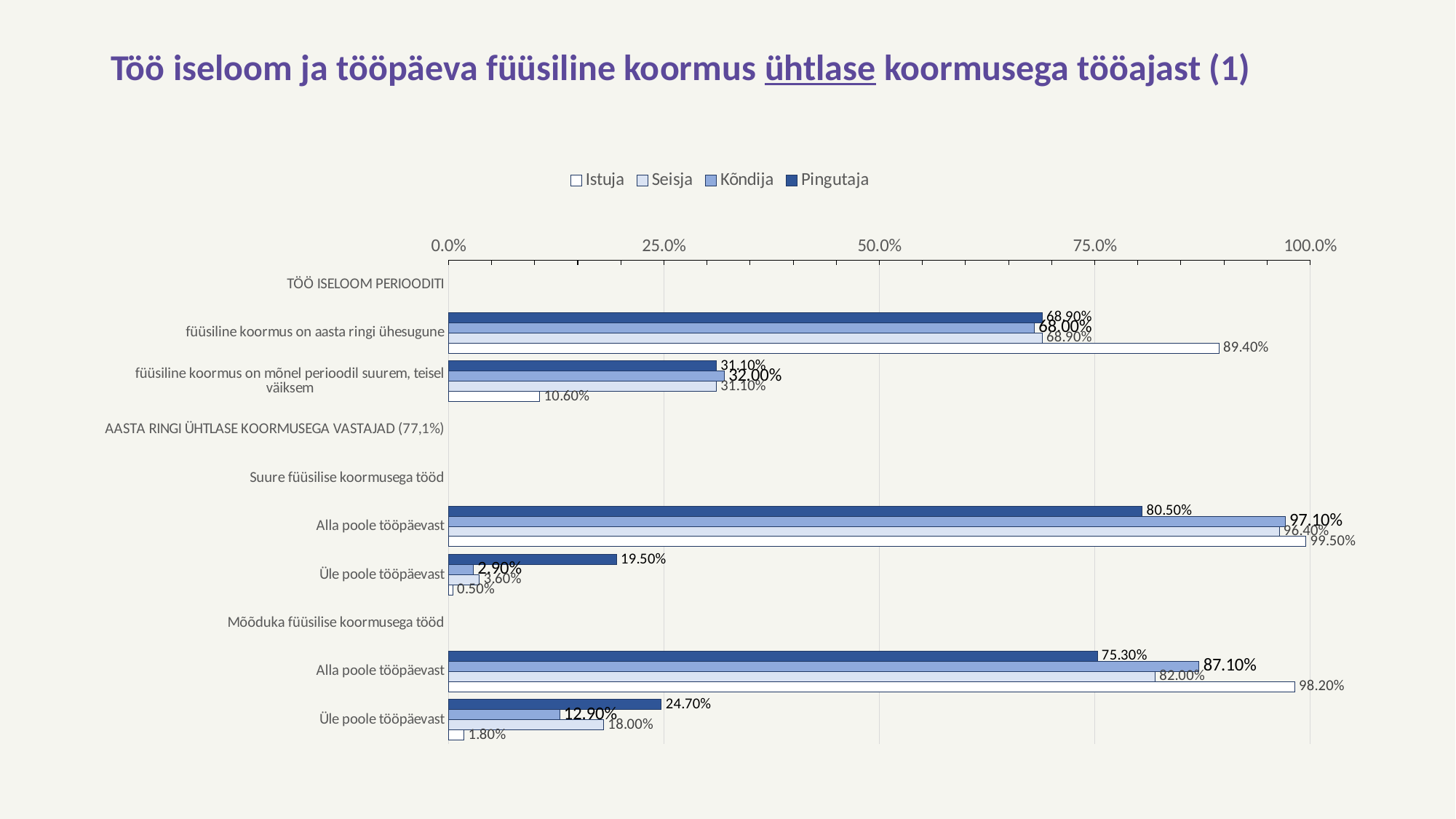
Under 'Suure füüsilise koormusega tööd', what is the value for Istuja in 'Üle poole tööpäevast'? 0.50% Under 'Mõõduka füüsilise koormusega tööd', what is the value for Seisja in 'Alla poole tööpäevast'? 82.00% How many series does the legend list? 4 In the category 'füüsiline koormus on aasta ringi ühesugune', which is larger: Istuja or Pingutaja? Istuja Which series are listed in the legend? Istuja, Seisja, Kõndija, Pingutaja Under 'Suure füüsilise koormusega tööd', which series has the lowest value in 'Üle poole tööpäevast'? Istuja What kind of chart is shown on the slide? bar chart Under 'Mõõduka füüsilise koormusega tööd', what is the value for Kõndija in 'Alla poole tööpäevast'? 87.10% Under 'Mõõduka füüsilise koormusega tööd', what is the difference between Pingutaja and Istuja in 'Üle poole tööpäevast'? 22.90% Under 'Mõõduka füüsilise koormusega tööd', which series has the highest value in 'Alla poole tööpäevast'? Istuja What is the value for Istuja in the category 'füüsiline koormus on aasta ringi ühesugune'? 89.40% What is the value for Pingutaja in the category 'füüsiline koormus on mõnel perioodil suurem, teisel väiksem'? 31.10%